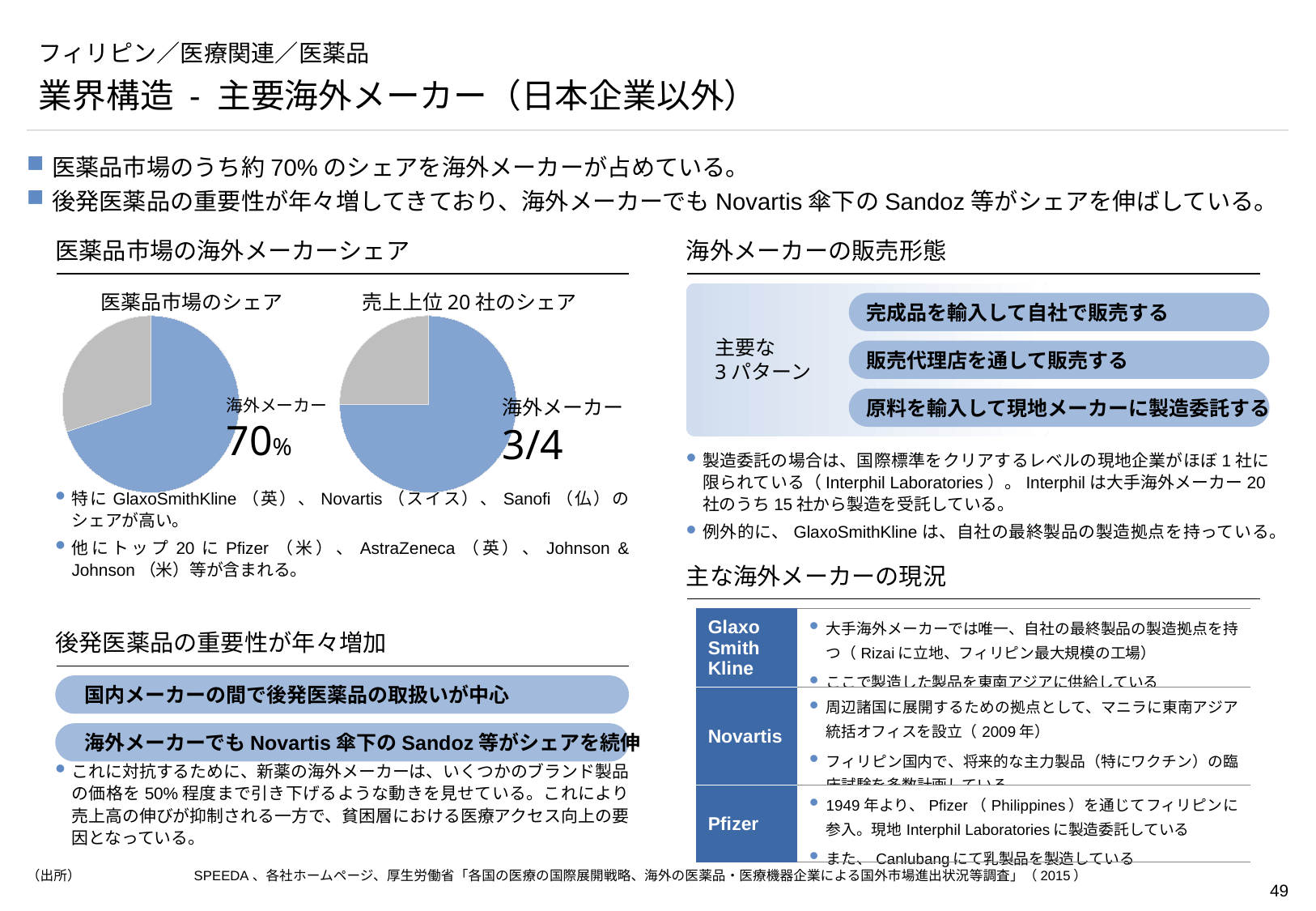
In the pie chart titled 医薬品市場のシェア, what colour is the 海外メーカー slice? Blue In the pie chart titled 医薬品市場のシェア, what share is labelled for 海外メーカー? 70% In the pie chart titled 医薬品市場のシェア, is the 海外メーカー slice larger or smaller than the other slice? Larger How many slices does the pie chart titled 医薬品市場のシェア have? 2 In the pie chart titled 医薬品市場のシェア, what share of the market is not held by 海外メーカー? 30% How many slices does the pie chart titled 売上上位20社のシェア have? 2 In the pie chart titled 売上上位20社のシェア, what share is labelled for 海外メーカー? 3/4 What kind of chart is used for 医薬品市場のシェア? Pie chart How many pie charts are shown under the heading 医薬品市場の海外メーカーシェア? 2 What kind of chart is used for 売上上位20社のシェア? Pie chart